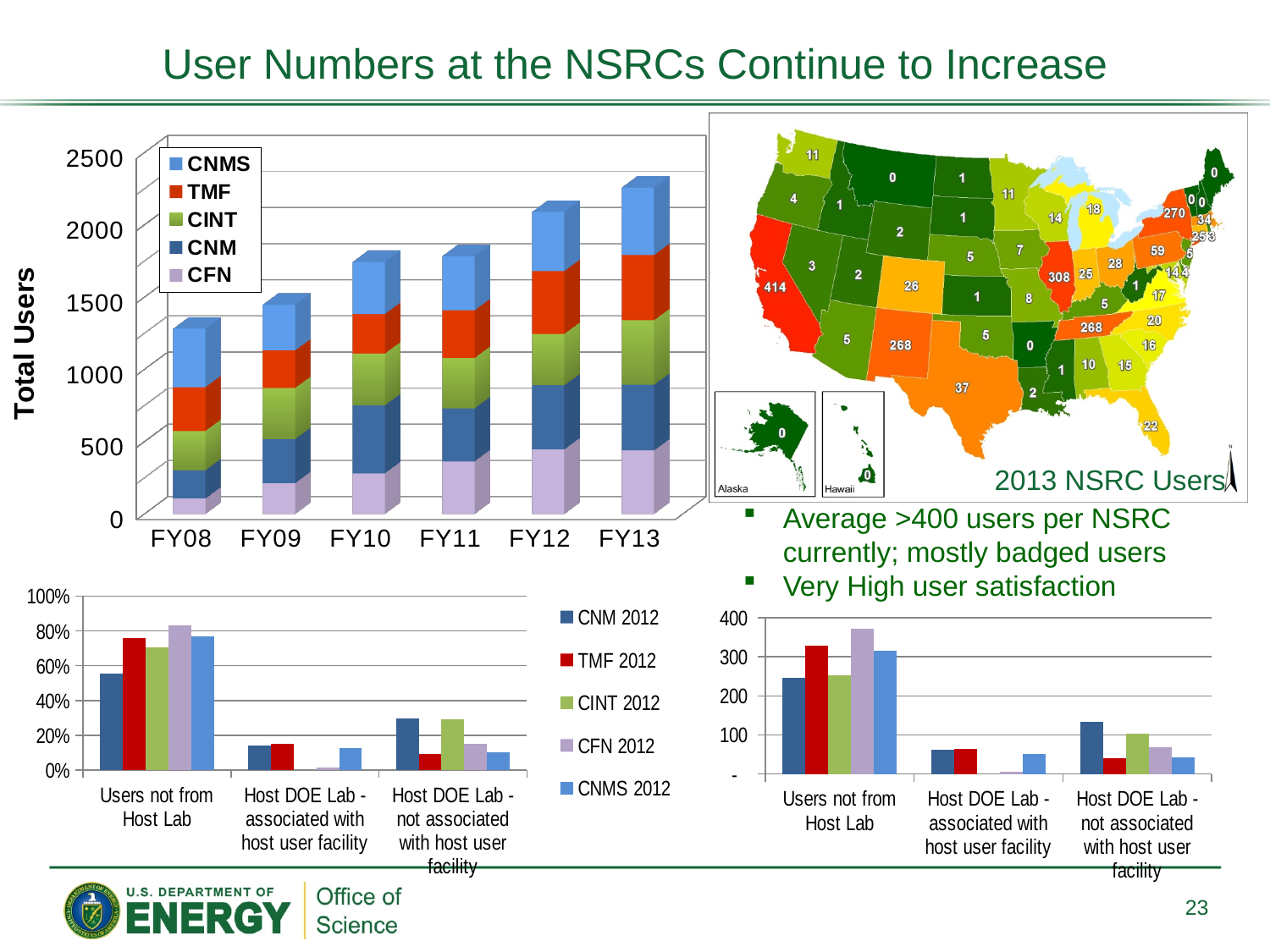
In the bottom-right chart with the 0–400 axis, how many categories are shown on the x axis? 3 In the bottom-left percentage chart, how many series does the legend list? 5 In the top-left 'Total Users' chart, which fiscal year has the lowest total? FY08 In the bottom-left percentage chart, which series has the highest value for 'Users not from Host Lab'? CFN 2012 In the top-left 'Total Users' chart, is the total for FY08 greater or less than 1000? greater In the bottom-left percentage chart, is the value of CNM 2012 for 'Users not from Host Lab' greater or less than 60%? less In the top-left 'Total Users' chart, do the total users rise or fall from FY08 to FY13? rise In the top-left 'Total Users' chart, how many series does the legend list? 5 In the top-left 'Total Users' chart, which fiscal year has the highest total? FY13 In the top-left 'Total Users' chart, how many fiscal years are shown on the x axis? 6 What type of chart is the top-left chart titled with the y-axis 'Total Users'? stacked bar chart In the top-left 'Total Users' chart, which series is listed first in the legend? CNMS